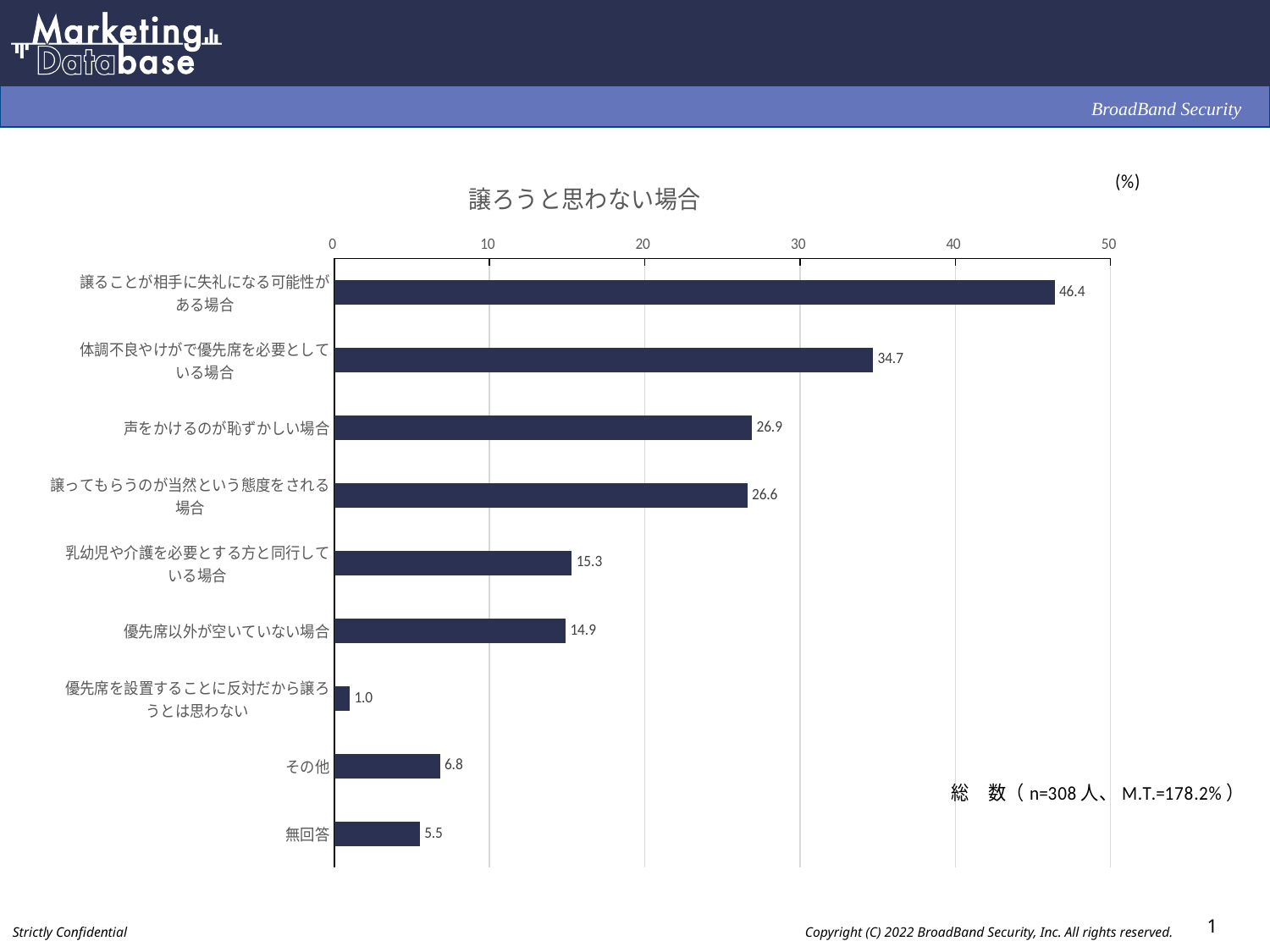
What is the difference between the values for 譲ることが相手に失礼になる可能性がある場合 and 体調不良やけがで優先席を必要としている場合? 11.7 Which is larger, the value for その他 or the value for 無回答? その他 What is the value for 優先席以外が空いていない場合? 14.9 What is the value for 譲ることが相手に失礼になる可能性がある場合? 46.4 What is the value for 声をかけるのが恥ずかしい場合? 26.9 Which category has the lowest value? 優先席を設置することに反対だから譲ろうとは思わない Which category has the highest value? 譲ることが相手に失礼になる可能性がある場合 What is the value for 無回答? 5.5 What is the title of the chart? 譲ろうと思わない場合 Is the value for 体調不良やけがで優先席を必要としている場合 greater or less than 30? greater What type of chart is shown on the slide? bar chart How many categories are plotted in the chart? 9